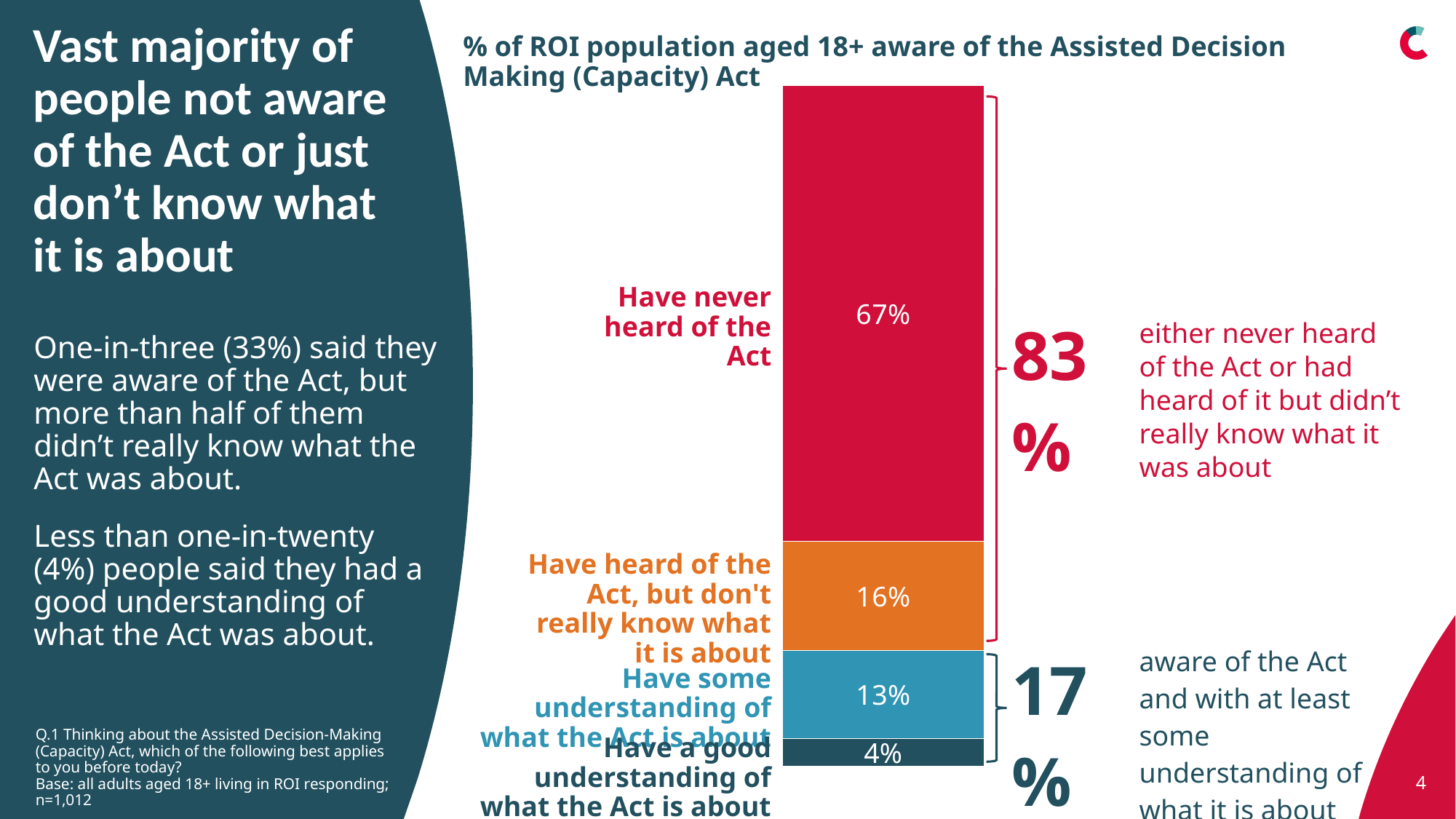
What combined percentage either never heard of the Act or had heard of it but didn't really know what it was about? 83% What is the title of the chart? % of ROI population aged 18+ aware of the Assisted Decision Making (Capacity) Act Which category has the smallest share of the population? Have a good understanding of what the Act is about How many segments make up the stacked bar? 4 What percentage have heard of the Act but don't really know what it is about? 16% What percentage have some understanding of what the Act is about? 13% Which category has the largest share of the population? Have never heard of the Act What is the difference between the share who have never heard of the Act and the share who have heard of it but don't really know what it is about? 51% What percentage of the ROI population aged 18+ have never heard of the Act? 67% Which is larger: the share with some understanding of the Act or the share with a good understanding? Have some understanding of what the Act is about What type of chart is shown on the slide? Stacked bar chart What percentage have a good understanding of what the Act is about? 4%